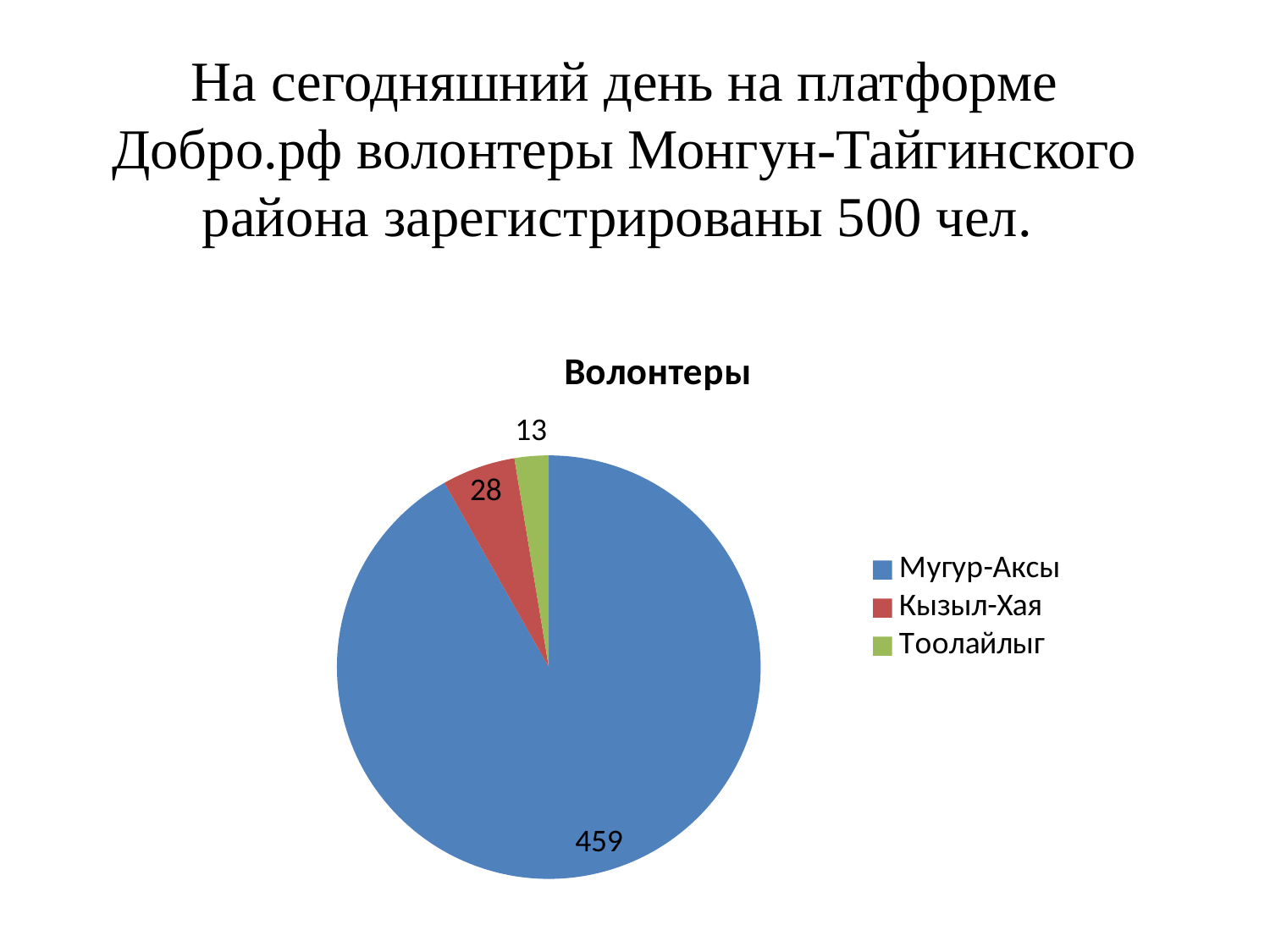
Which category has the smallest slice? Тоолайлыг Which category has the largest slice? Мугур-Аксы What is the title of the chart? Волонтеры What is the difference between the values for Кызыл-Хая and Тоолайлыг? 15 What type of chart is shown on the slide? pie chart How many slices does the pie chart have? 3 What is the difference between the values for Мугур-Аксы and Кызыл-Хая? 431 What is the value for Мугур-Аксы? 459 What is the value for Тоолайлыг? 13 What share of the pie does Мугур-Аксы represent? 91.8% Which is larger, the value for Кызыл-Хая or the value for Тоолайлыг? Кызыл-Хая What is the value for Кызыл-Хая? 28